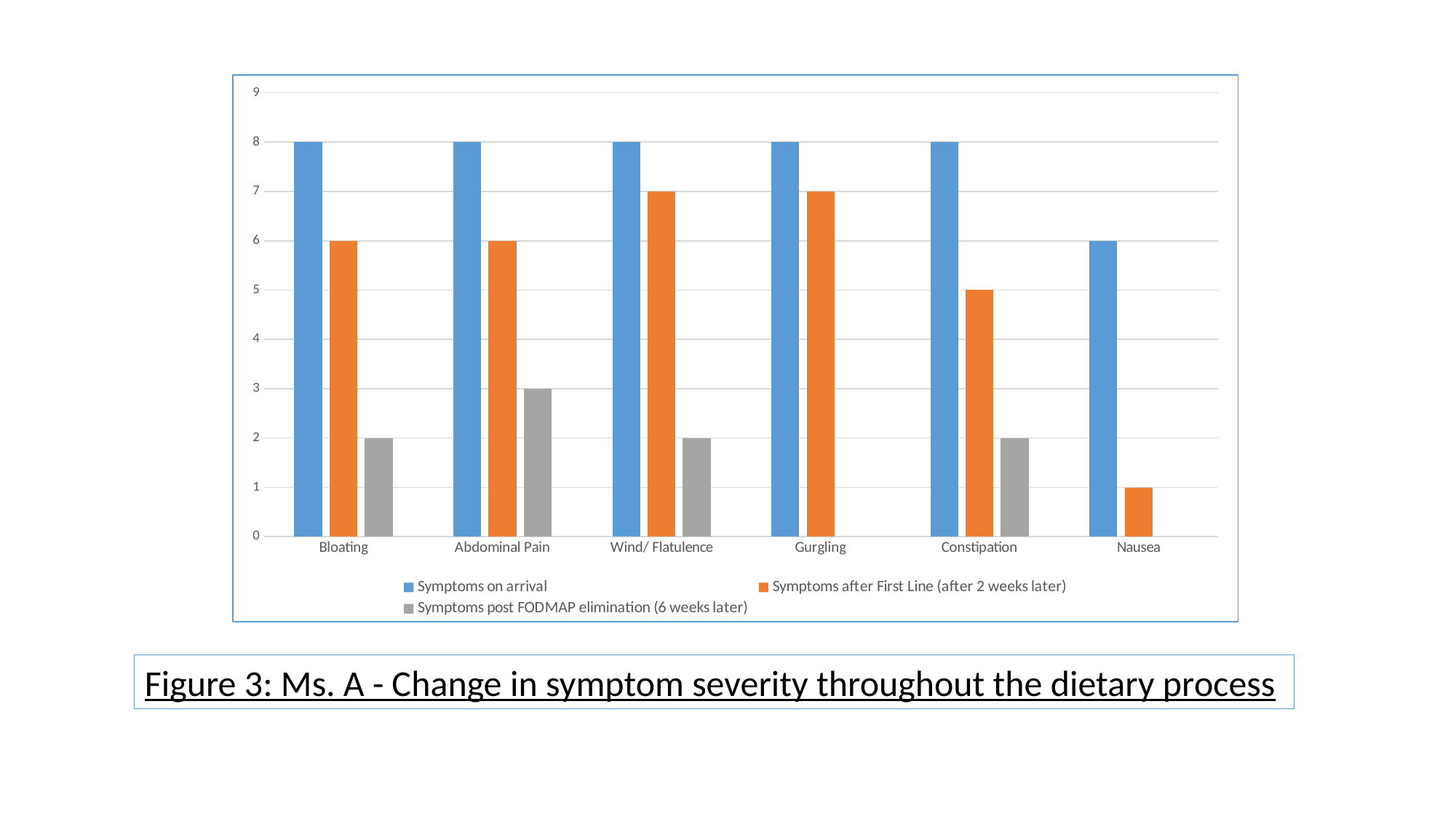
Which is larger for Gurgling: Symptoms on arrival or Symptoms after First Line (after 2 weeks later)? Symptoms on arrival Which category has the highest value for Symptoms after First Line (after 2 weeks later)? Wind/ Flatulence and Gurgling What is the value for Symptoms post FODMAP elimination (6 weeks later) for Abdominal Pain? 3 What is the value for Symptoms on arrival for Bloating? 8 Which category has the lowest value for Symptoms on arrival? Nausea What is the difference between Symptoms on arrival and Symptoms post FODMAP elimination (6 weeks later) for Bloating? 6 What kind of chart is shown on the slide? Bar chart How many symptom categories are shown on the x axis? 6 What is the value for Symptoms after First Line (after 2 weeks later) for Nausea? 1 How many series does the legend list? 3 What is the figure caption shown below the chart? Figure 3: Ms. A - Change in symptom severity throughout the dietary process What is the value for Symptoms after First Line (after 2 weeks later) for Constipation? 5